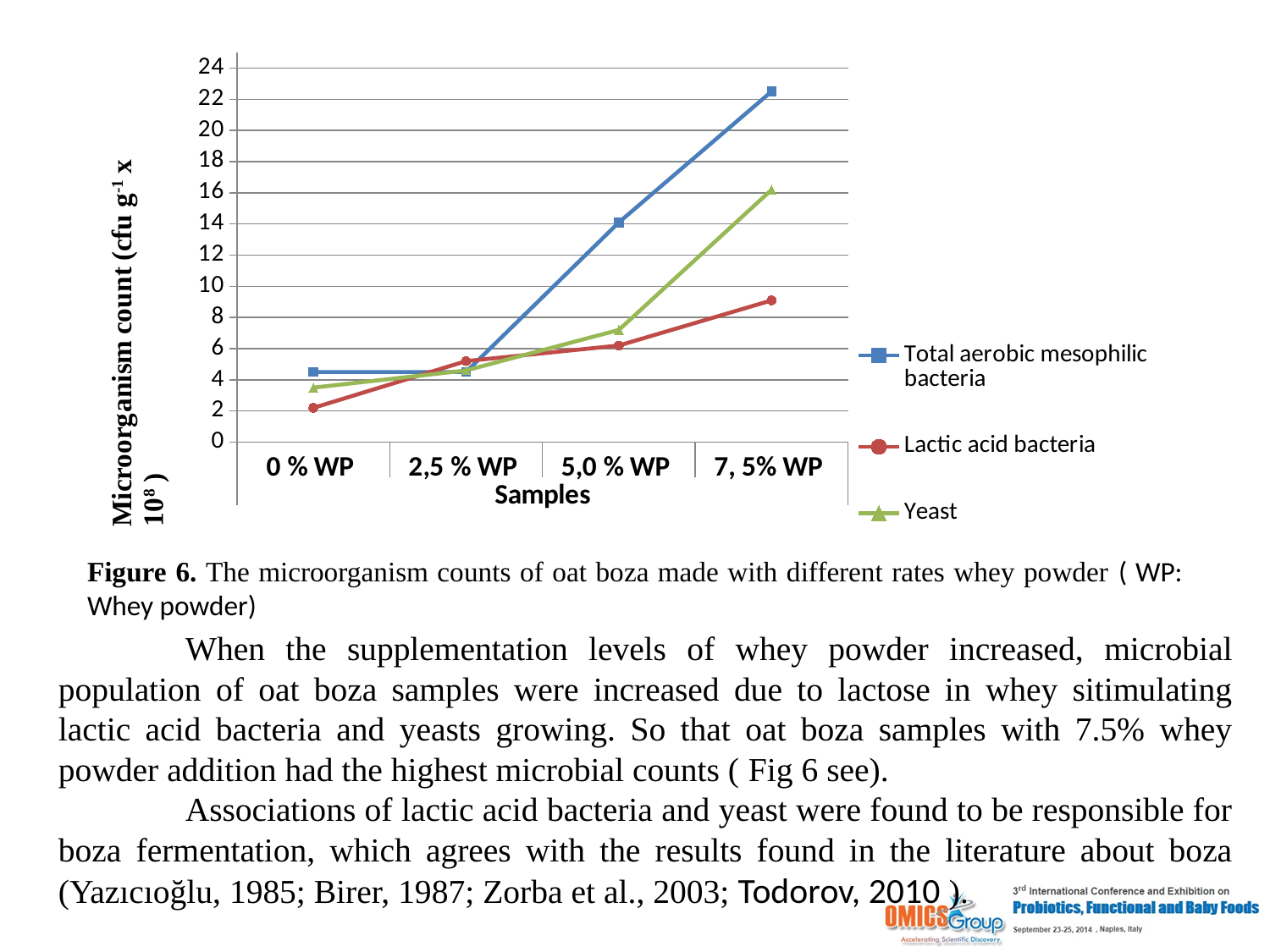
What is the title of the x axis? Samples Does the Total aerobic mesophilic bacteria count rise or fall from 2,5 % WP to 7, 5% WP? rise Is the Lactic acid bacteria value at 0 % WP greater or less than 4? less Is the Yeast value at 7, 5% WP greater or less than 14? greater How many series does the legend list? 3 Is the Total aerobic mesophilic bacteria value at 7, 5% WP greater or less than 20? greater Which sample has the highest Total aerobic mesophilic bacteria count? 7, 5% WP Which sample has the lowest Lactic acid bacteria count? 0 % WP What kind of chart is shown on the slide? line chart Which series has the highest value at 7, 5% WP? Total aerobic mesophilic bacteria How many sample categories are shown on the x axis? 4 At 7, 5% WP, which is larger: the Yeast count or the Lactic acid bacteria count? Yeast